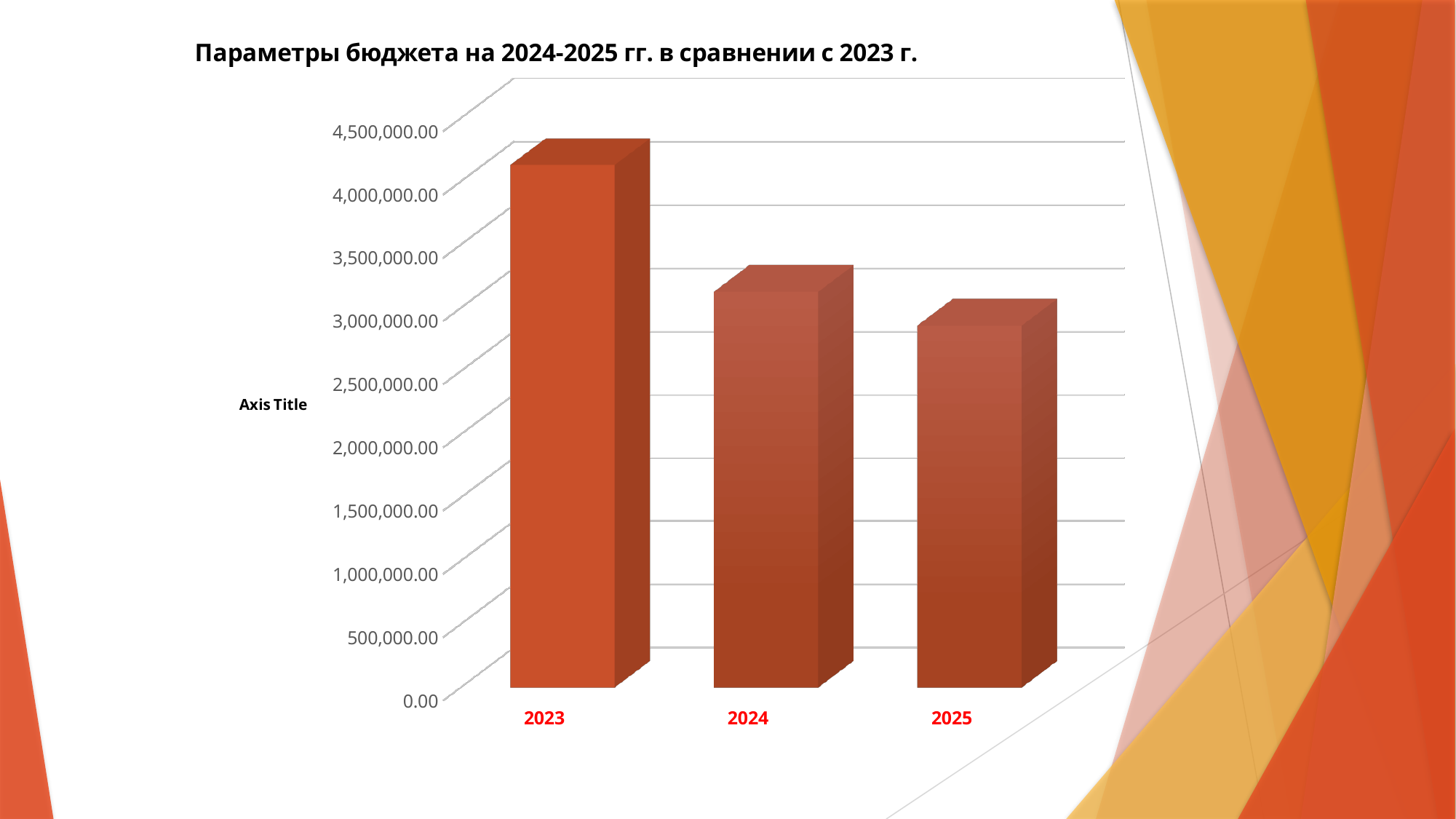
Is the value for 2025 greater or less than 2,500,000.00? greater Which year has the lowest bar? 2025 What is the title of the chart? Параметры бюджета на 2024-2025 гг. в сравнении с 2023 г. What kind of chart is shown on the slide? bar chart Is the value for 2023 greater or less than 4,000,000.00? greater How many categories (years) are plotted in the chart? 3 Do the values rise or fall from 2023 to 2025? fall Is the value for 2025 greater or less than 3,500,000.00? less Which year has the highest bar? 2023 Which is larger, the value for 2023 or the value for 2024? 2023